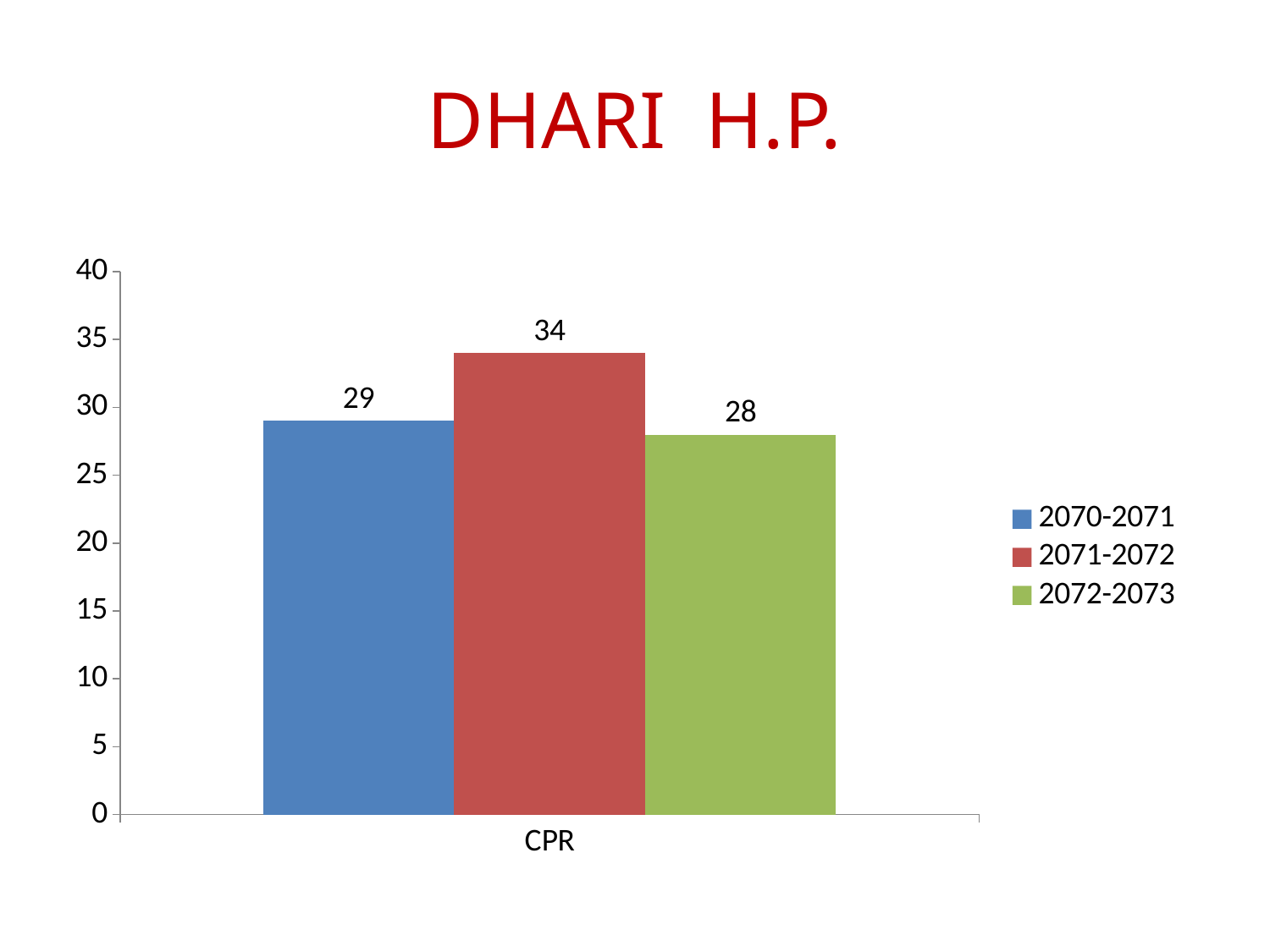
Is the CPR value for 2071-2072 greater or less than 30? greater Which is larger, the CPR value for 2070-2071 or for 2072-2073? 2070-2071 What is the difference between the CPR values for 2071-2072 and 2070-2071? 5 What is the title of the slide? DHARI H.P. Which year has the highest CPR value? 2071-2072 How many series does the legend list? 3 What is the CPR value for 2072-2073? 28 What is the CPR value for 2070-2071? 29 What is the CPR value for 2071-2072? 34 Which year has the lowest CPR value? 2072-2073 What is the difference between the CPR values for 2071-2072 and 2072-2073? 6 What kind of chart is shown on the slide? bar chart